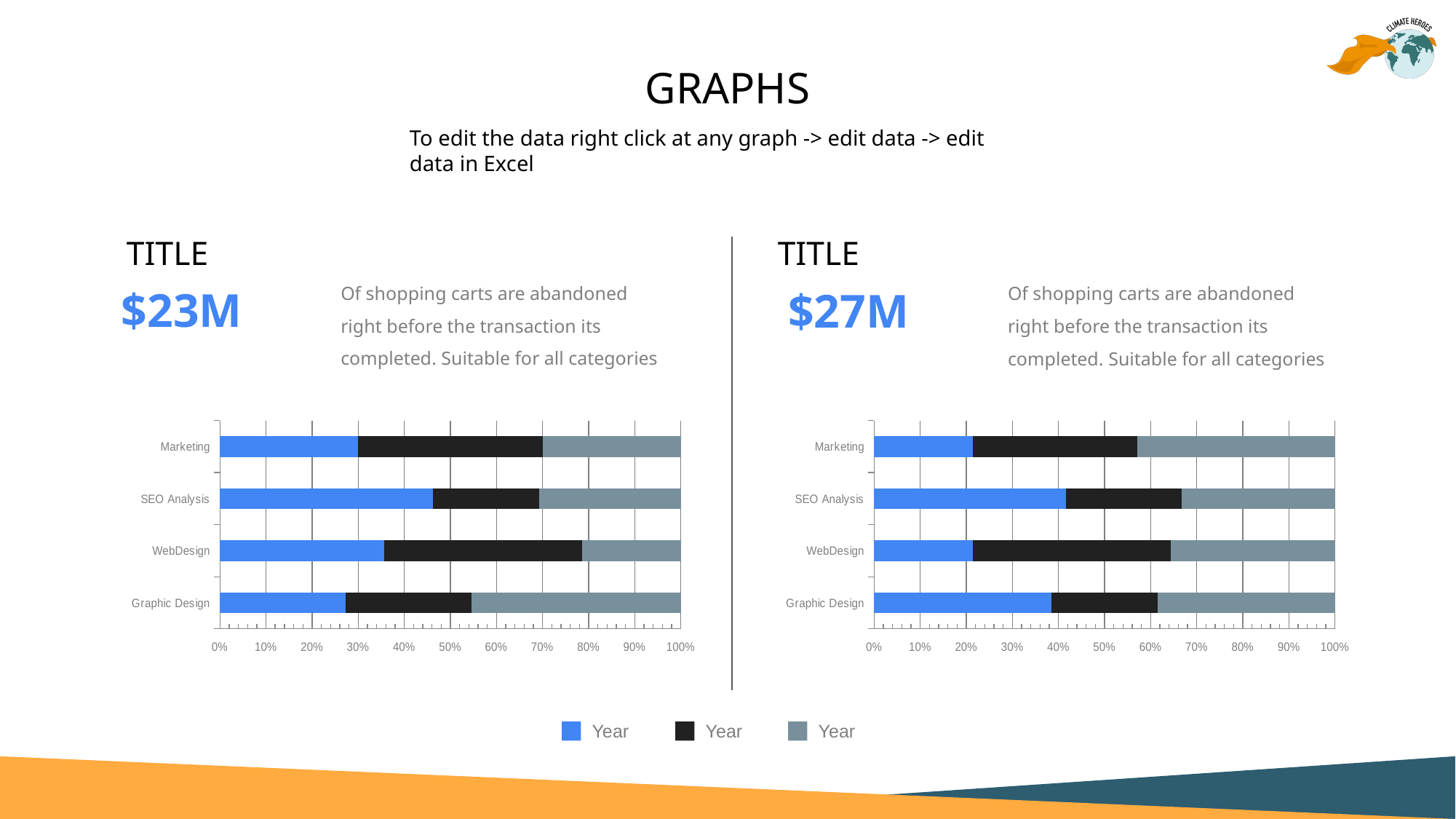
How many categories does the right chart show? 4 In the left chart, which category has the largest blue (first series) segment? SEO Analysis What is the maximum value shown on the x axis of the left chart? 100% In the left chart, is the blue segment larger for SEO Analysis or for Marketing? SEO Analysis What kind of chart is the left chart? bar chart In the right chart, is the blue segment for Marketing greater or less than 30%? less In the left chart, is the blue segment for Graphic Design greater or less than 30%? less How many series does the legend list? 3 What label is used for every series in the legend? Year In the right chart, is the blue segment larger for Graphic Design or for Marketing? Graphic Design In the right chart, is the blue segment for SEO Analysis greater or less than 30%? greater